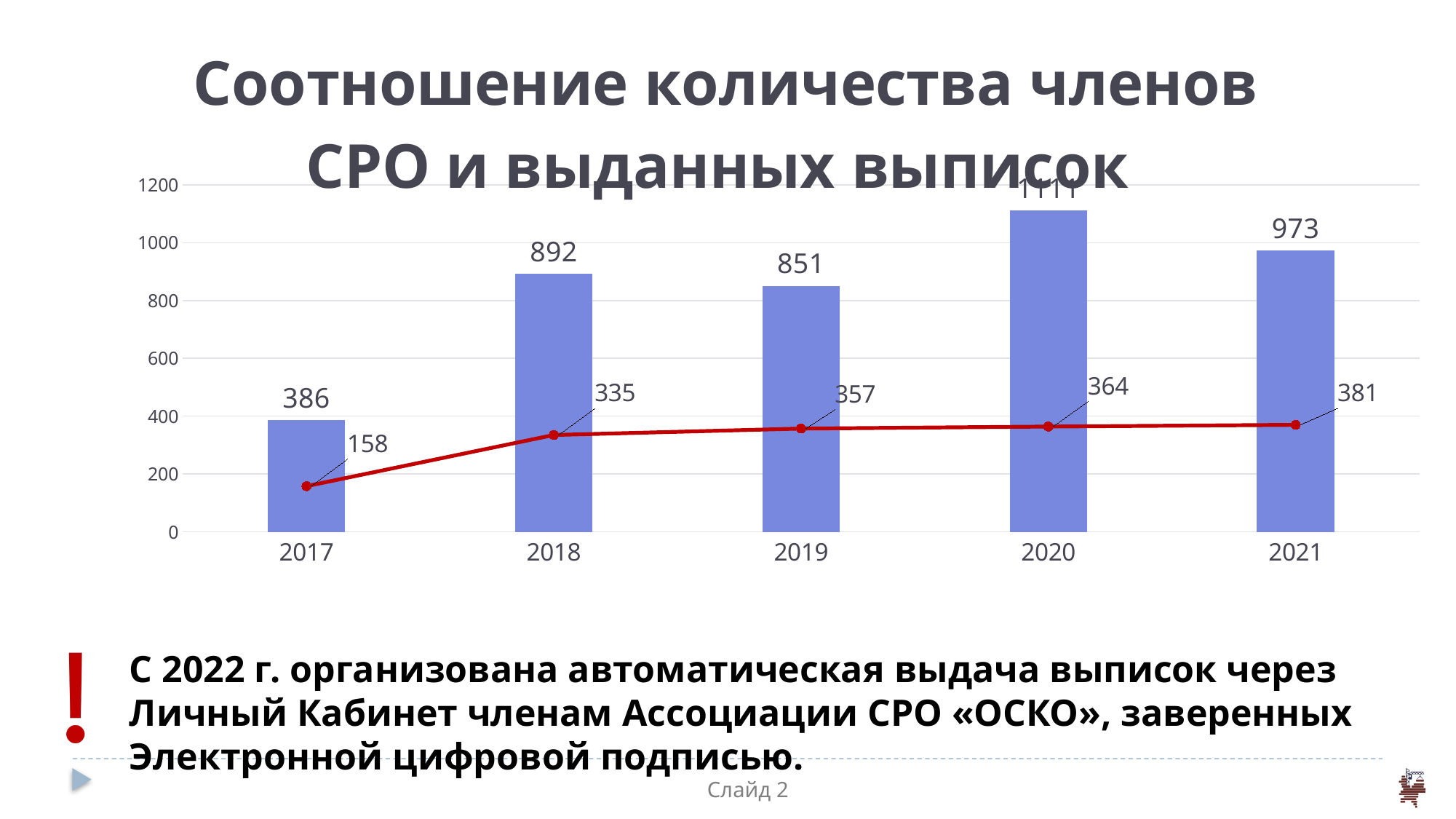
How many years are shown on the x axis? 5 Which bar is taller, 2019 or 2021? 2021 By how much did the red line value increase from 2017 to 2018? 177 What is the value of the red line point for 2019? 357 What is the value of the bar for 2018? 892 What is the value of the bar for 2017? 386 In which year is the bar the highest? 2020 In which year is the red line value the lowest? 2017 Is the bar value for 2020 greater or less than 1000? greater What is the value of the red line point for 2021? 381 In which year is the bar the lowest? 2017 What is the difference between the bar values for 2018 and 2019? 41